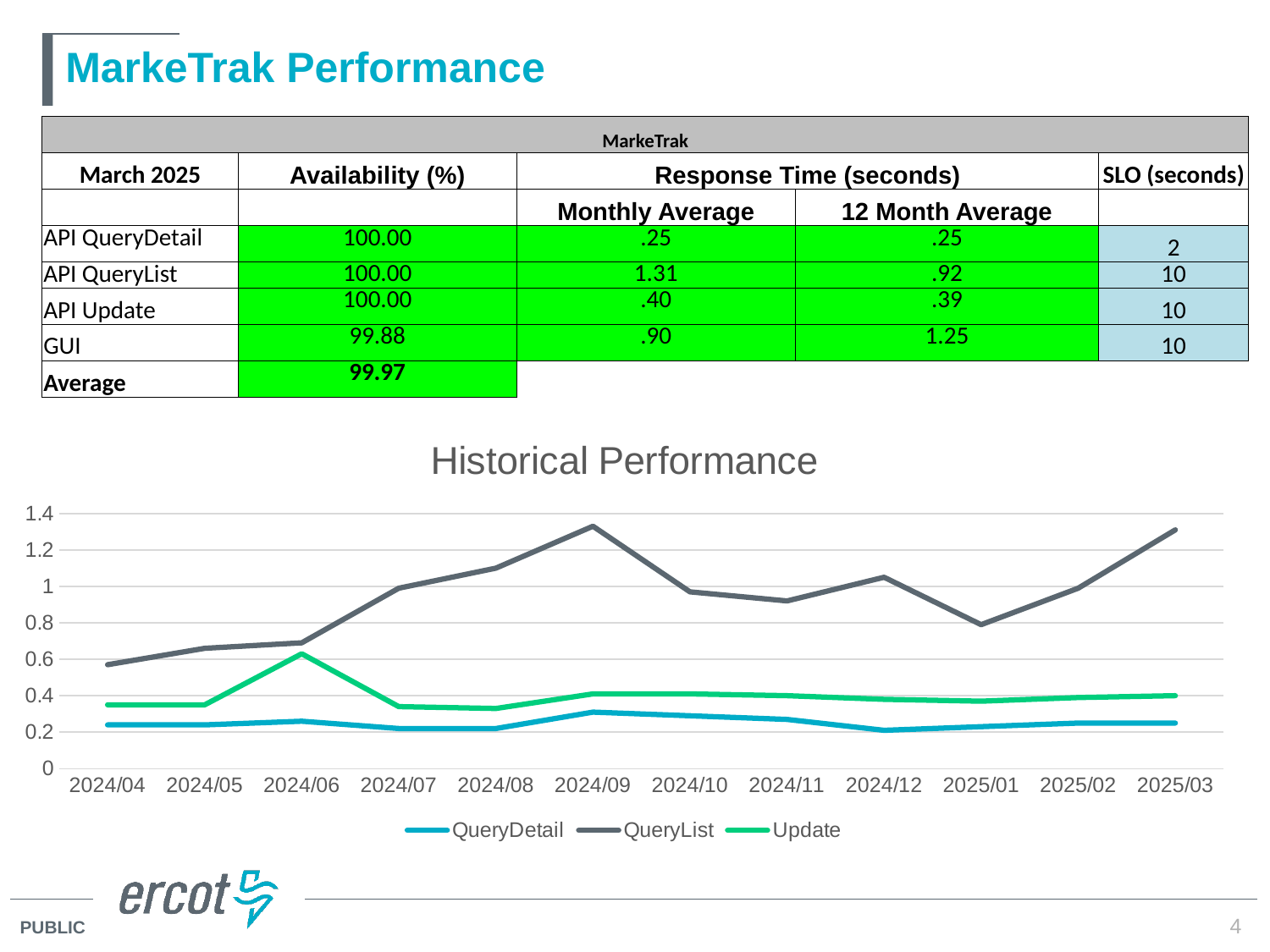
Does the QueryList series rise or fall from 2024/04 to 2024/09? rise Which series in the Historical Performance chart has the lowest values throughout the period? QueryDetail Is the QueryList value for 2024/04 greater or less than 0.6? less Which series in the Historical Performance chart has the highest values throughout the period? QueryList How many series does the legend of the Historical Performance chart list? 3 What is the title of the line chart on the slide? Historical Performance In which month does the Update series reach its highest value in the Historical Performance chart? 2024/06 Is the QueryList value for 2024/09 greater or less than 1.2? greater Is the Update value for 2024/06 greater or less than 0.6? greater How many months are plotted along the x axis of the Historical Performance chart? 12 What kind of chart is the Historical Performance chart? line chart Which is larger at 2024/06: the Update value or the QueryDetail value? Update